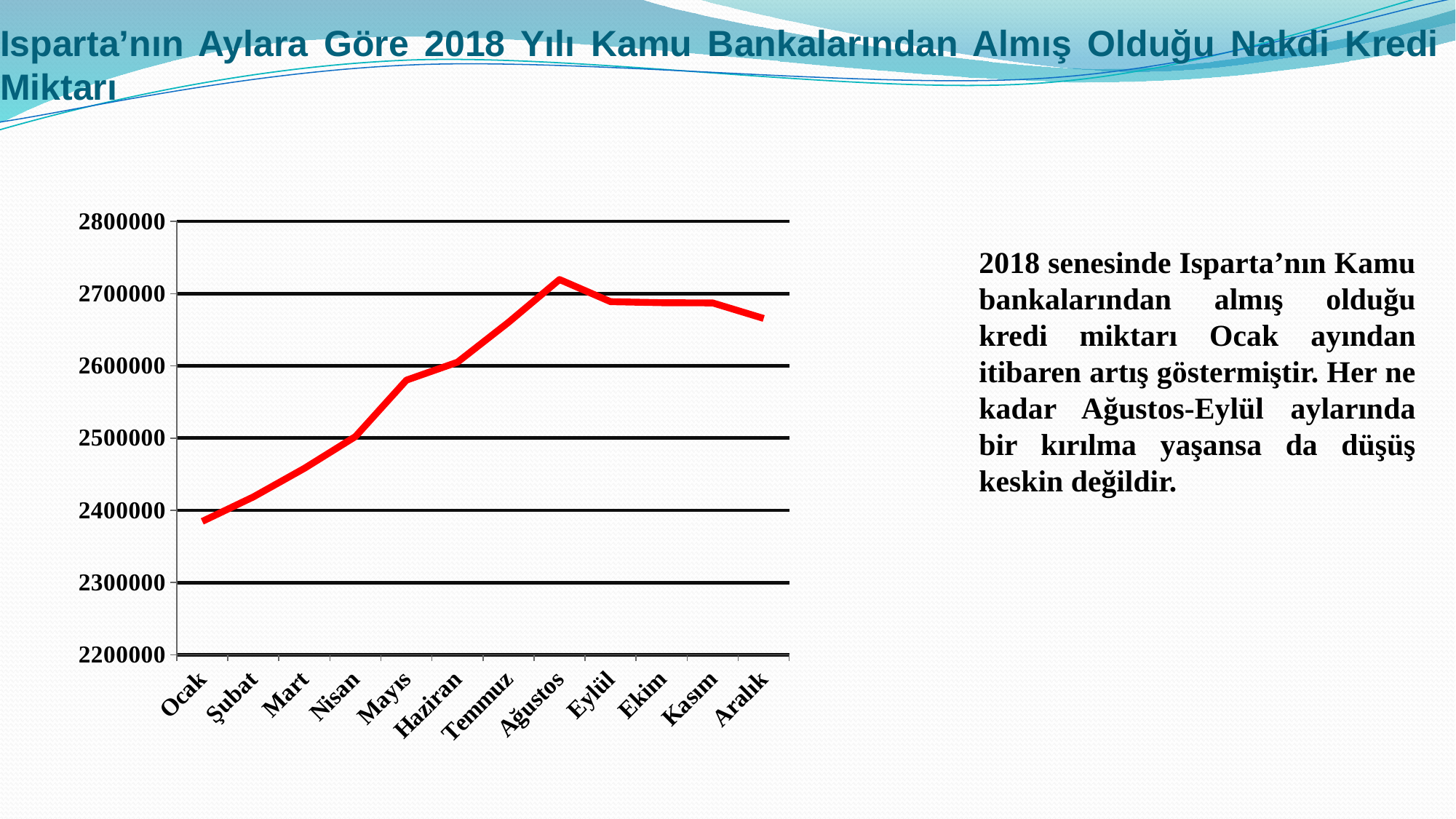
Is the value for Aralık greater or less than 2700000? less In which month does the line have its lowest value? Ocak Which month has the larger value, Temmuz or Şubat? Temmuz Is the value for Ocak greater or less than 2400000? less Is the value for Mart greater or less than 2500000? less What colour is the line in the chart? red Does the line rise or fall from Ocak to Ağustos? rise What kind of chart is shown on the slide? line chart In which month does the line reach its highest value? Ağustos How many months are plotted along the x axis of the chart? 12